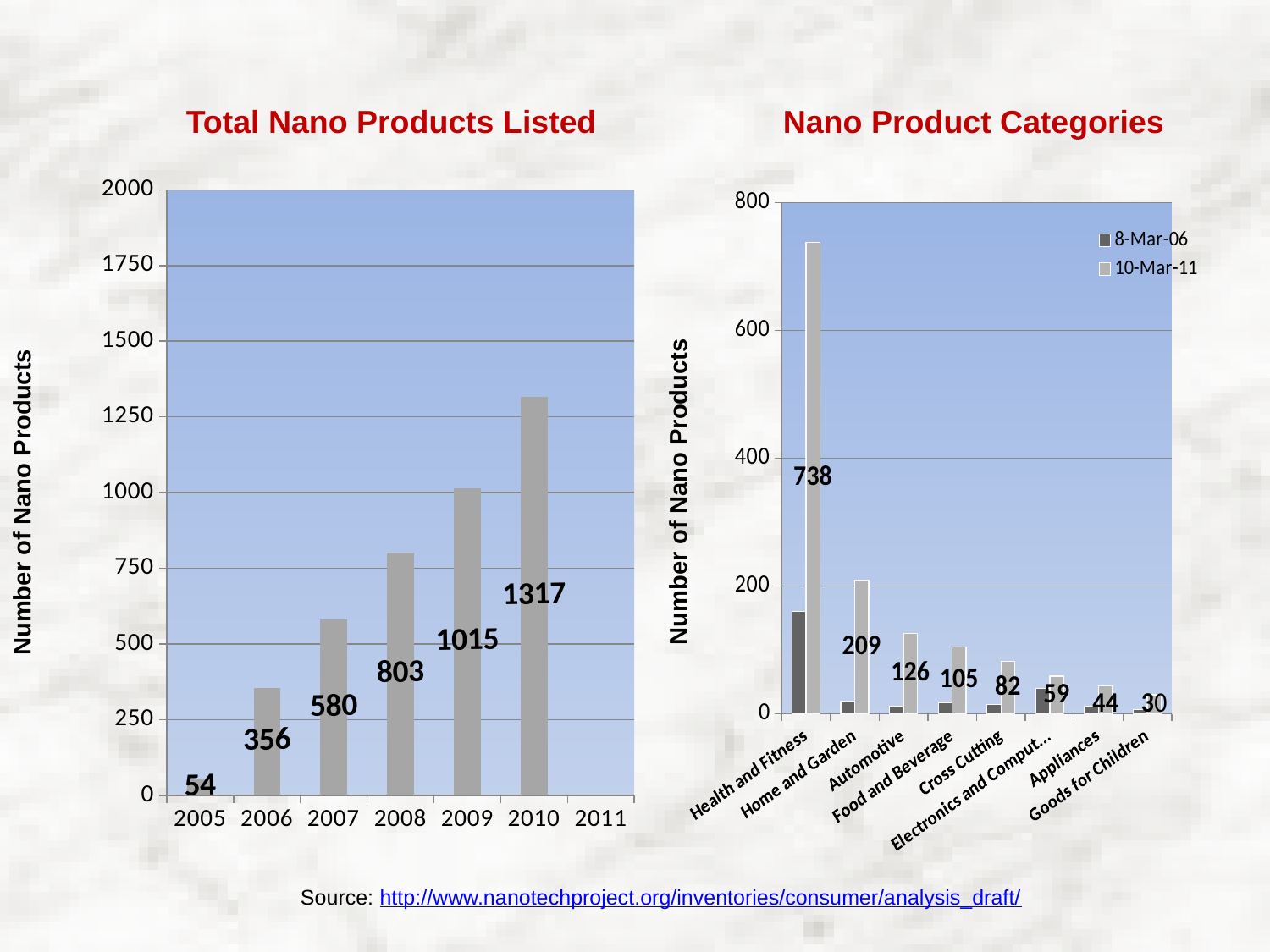
In the 'Nano Product Categories' chart, which category has the lowest 10-Mar-11 value? Goods for Children How many categories are shown on the x axis of the 'Nano Product Categories' chart? 8 In the 'Total Nano Products Listed' chart, how many nano products were listed in 2008? 803 In the 'Nano Product Categories' chart, what is the difference between the 10-Mar-11 values for Automotive and Food and Beverage? 21 How many series does the legend of the 'Nano Product Categories' chart list? 2 In the 'Total Nano Products Listed' chart, do the values rise or fall from 2005 to 2010? rise In the 'Nano Product Categories' chart, is the 8-Mar-06 value for Health and Fitness greater or less than 200? less In the 'Nano Product Categories' chart, which category has the highest 10-Mar-11 value? Health and Fitness In the 'Total Nano Products Listed' chart, which year has the highest number of nano products? 2010 What kind of chart is 'Total Nano Products Listed'? bar chart In the 'Total Nano Products Listed' chart, what is the difference between the 2010 and 2009 values? 302 In the 'Nano Product Categories' chart, what is the 10-Mar-11 value for Home and Garden? 209